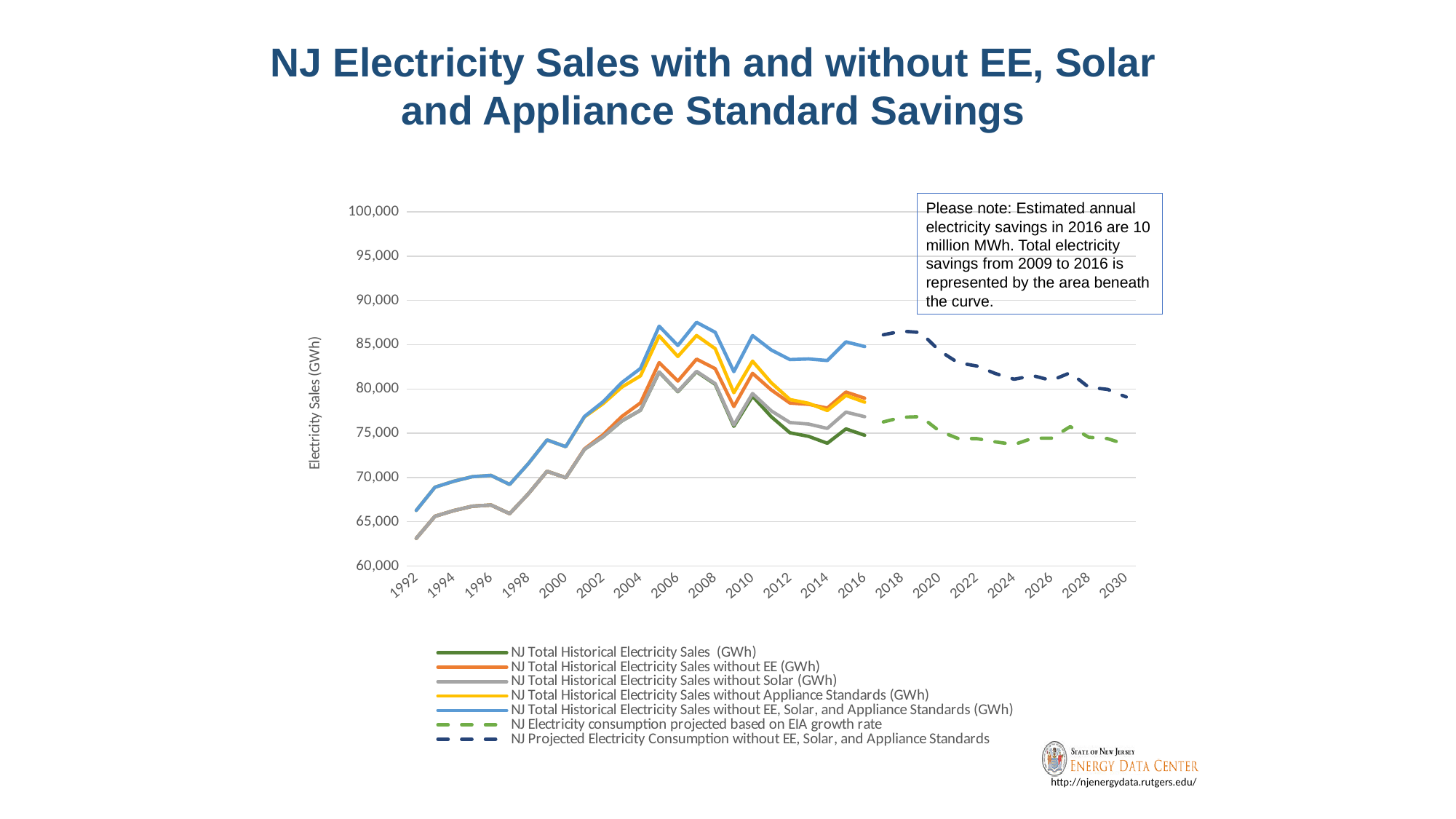
In 2020, which is larger: NJ Projected Electricity Consumption without EE, Solar, and Appliance Standards or NJ Electricity consumption projected based on EIA growth rate? NJ Projected Electricity Consumption without EE, Solar, and Appliance Standards Is the value for NJ Total Historical Electricity Sales without EE, Solar, and Appliance Standards (GWh) in 2007 greater or less than 85,000? greater What kind of chart is shown on the slide? Line chart Which series has the lowest value in 2016? NJ Total Historical Electricity Sales (GWh) Is the value for NJ Total Historical Electricity Sales without Solar (GWh) in 1992 greater or less than 65,000? less How many series does the legend list? 7 What is the title of the slide's chart? NJ Electricity Sales with and without EE, Solar and Appliance Standard Savings Which series has the highest value in 2016? NJ Total Historical Electricity Sales without EE, Solar, and Appliance Standards (GWh) What is the label on the vertical axis? Electricity Sales (GWh) Does NJ Projected Electricity Consumption without EE, Solar, and Appliance Standards rise or fall from 2018 to 2030? fall Is the value for NJ Total Historical Electricity Sales (GWh) in 2014 greater or less than 75,000? less